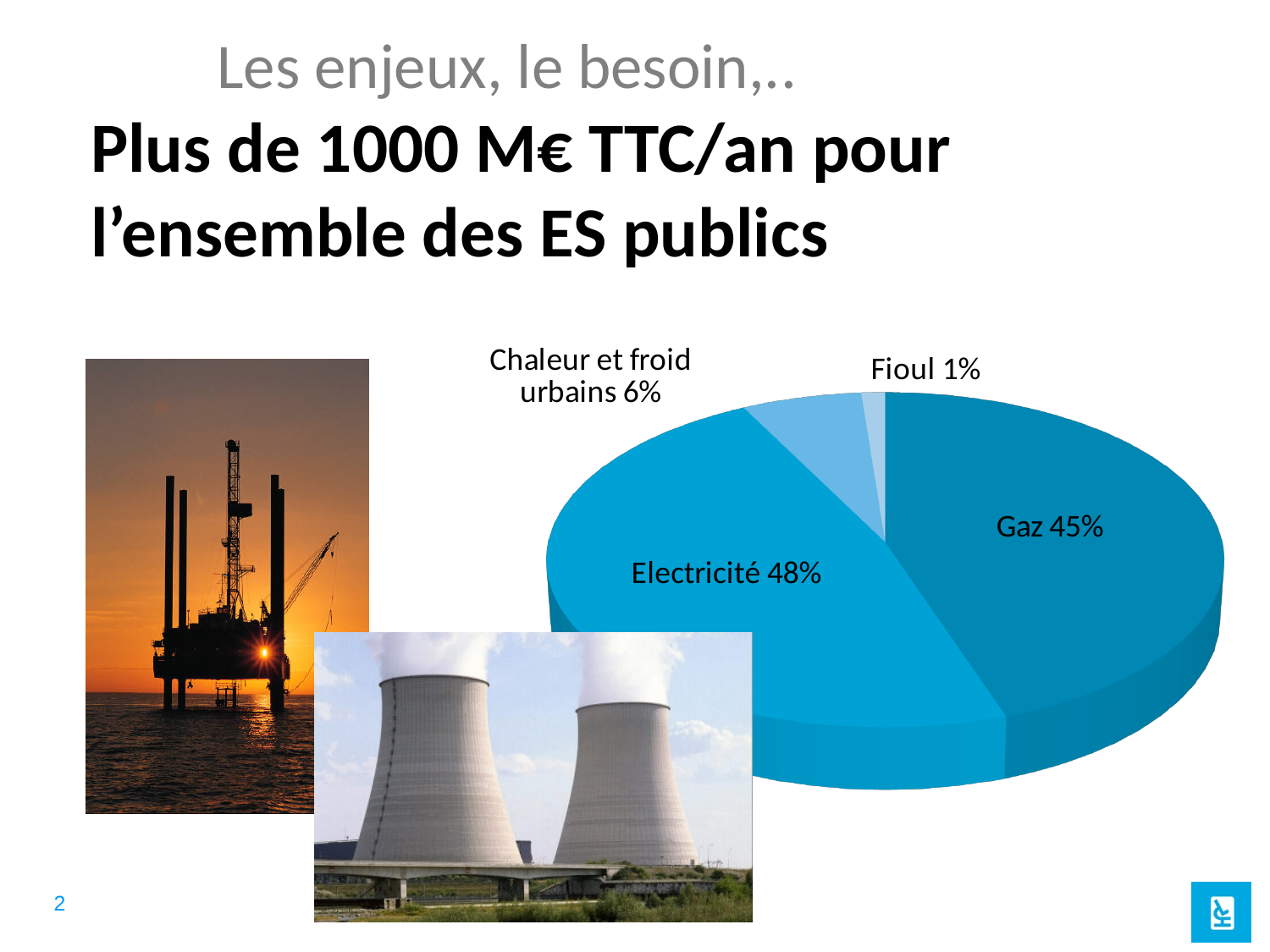
How many slices does the pie chart have? 4 What share of the pie does Gaz represent? 45% Which is larger, the share for Gaz or the share for Chaleur et froid urbains? Gaz Which category has the smallest slice of the pie? Fioul What kind of chart is shown on the slide? pie chart What is the difference in percentage points between Chaleur et froid urbains and Fioul? 5% What is the combined share of Gaz and Electricité? 93% What share of the pie does Chaleur et froid urbains represent? 6% What share of the pie does Electricité represent? 48% What is the difference in percentage points between Electricité and Gaz? 3% Which category has the largest slice of the pie? Electricité